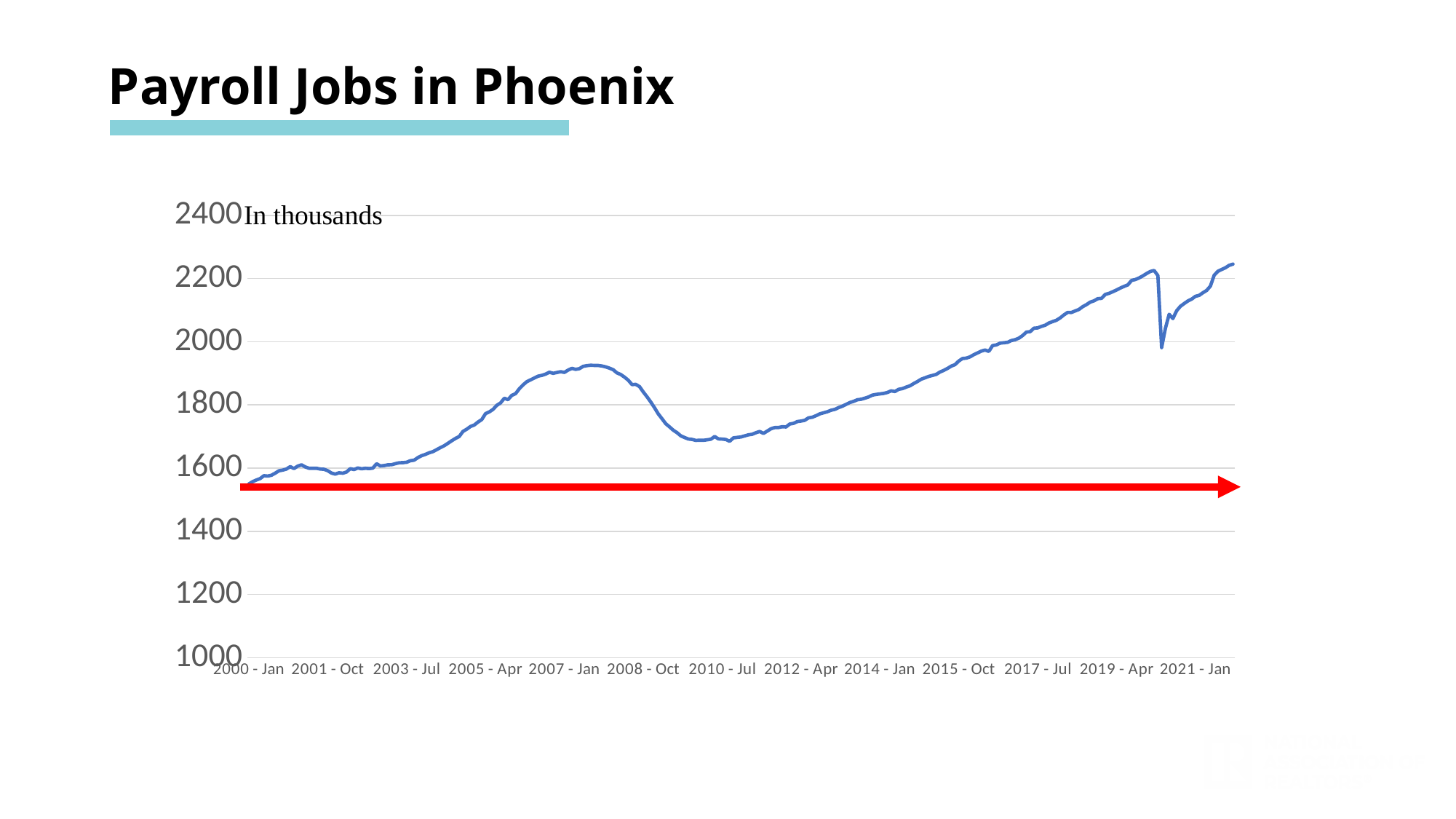
Is the value at 2021 - Jan greater or less than 2200? less Is the value at 2007 - Jan greater or less than 1800? greater Which is larger, the value at 2019 - Apr or the value at 2008 - Oct? 2019 - Apr In what units are the values on the chart expressed, according to the note near the top of the y axis? In thousands Overall, do the values rise or fall from 2000 - Jan to 2021 - Jan? rise What kind of chart is shown on the slide? line chart Which is larger, the value at 2007 - Jan or the value at 2010 - Jul? 2007 - Jan Is the value at 2010 - Jul greater or less than 1800? less What is the title of the chart on the slide? Payroll Jobs in Phoenix How many date labels are shown along the x axis? 13